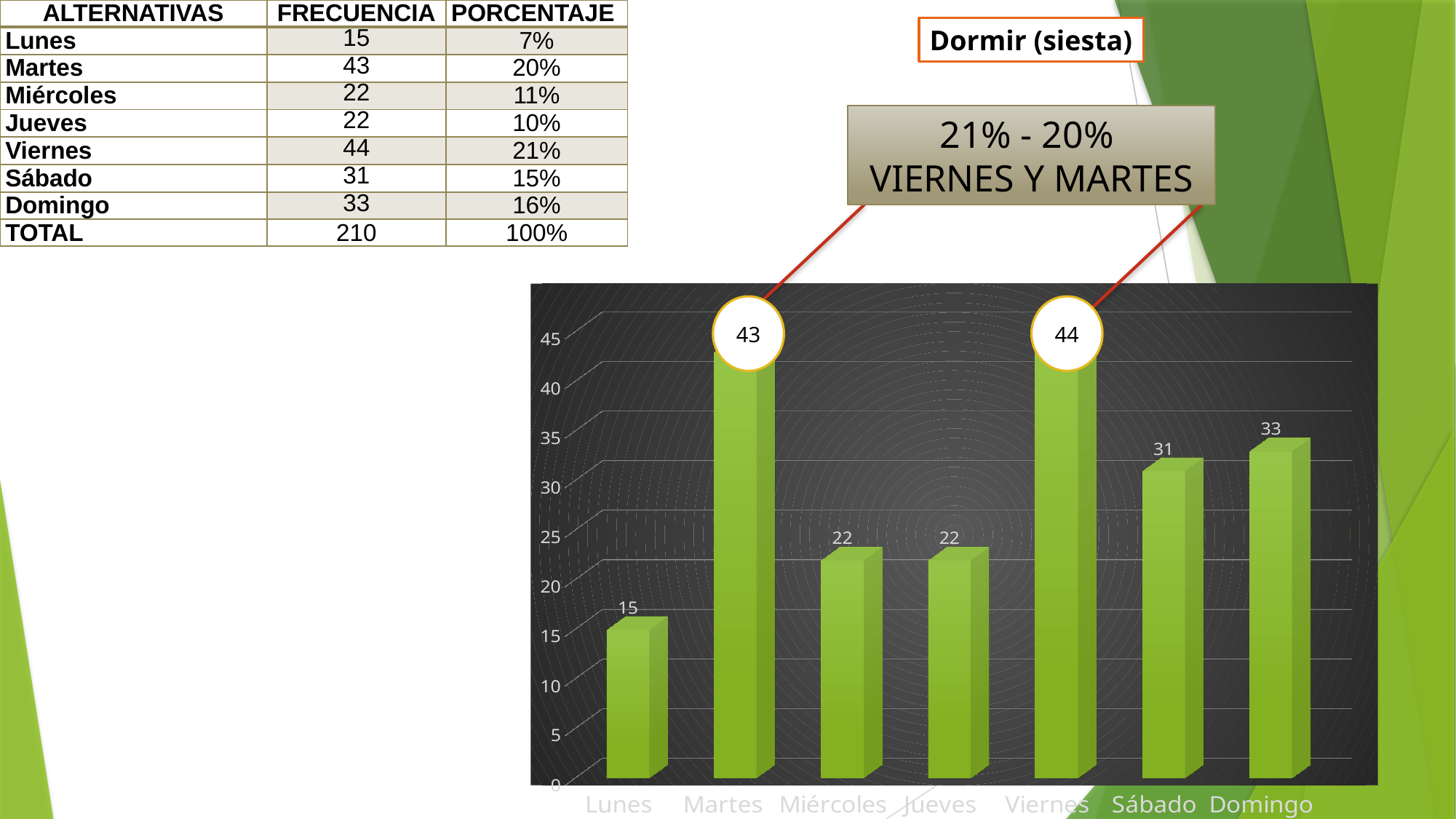
What kind of chart is shown on the slide? bar chart What is the title shown in the box above the chart? Dormir (siesta) What is the value for Lunes in the bar chart? 15 What is the difference between the values for Viernes and Martes? 1 What is the value for Sábado in the bar chart? 31 Which day has the highest value in the bar chart? Viernes What is the value for Domingo in the bar chart? 33 How many days (categories) are shown on the x axis of the bar chart? 7 What is the difference between the values for Domingo and Lunes? 18 Is the value for Jueves greater or less than 30? less Which is larger, the value for Sábado or the value for Miércoles? Sábado Which day has the lowest value in the bar chart? Lunes